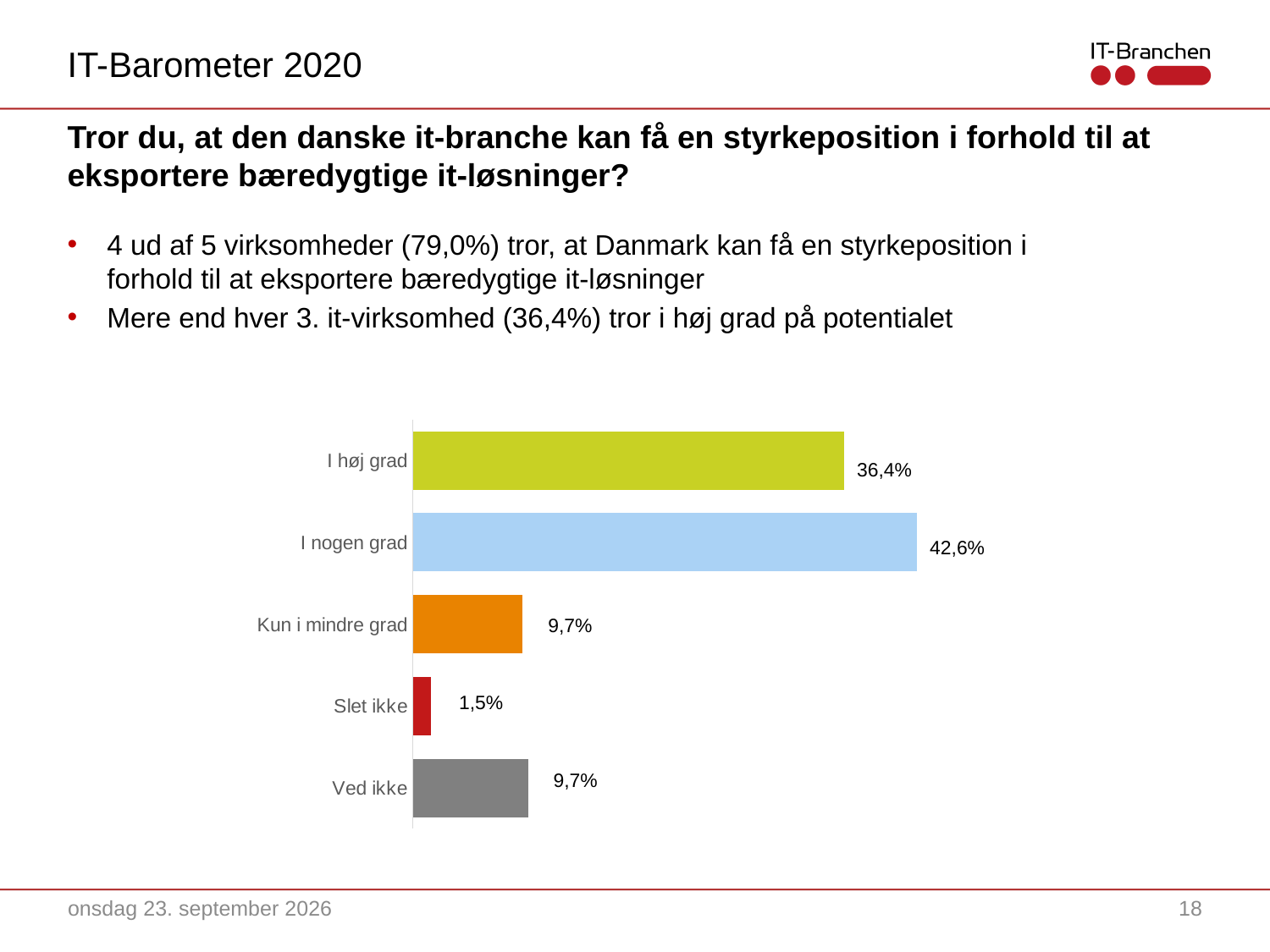
What is the difference between the values for "Kun i mindre grad" and "Slet ikke"? 8,2% What is the value for "I nogen grad"? 42,6% Which is larger, the value for "I høj grad" or the value for "Kun i mindre grad"? I høj grad What is the difference between the values for "I nogen grad" and "I høj grad"? 6,2% Which category has the highest value? I nogen grad What colour is the bar for "Slet ikke"? Red How many categories are shown in the chart? 5 What kind of chart is shown on the slide? Bar chart Which category has the lowest value? Slet ikke What is the value for "I høj grad"? 36,4% What is the value for "Slet ikke"? 1,5% What is the value for "Ved ikke"? 9,7%